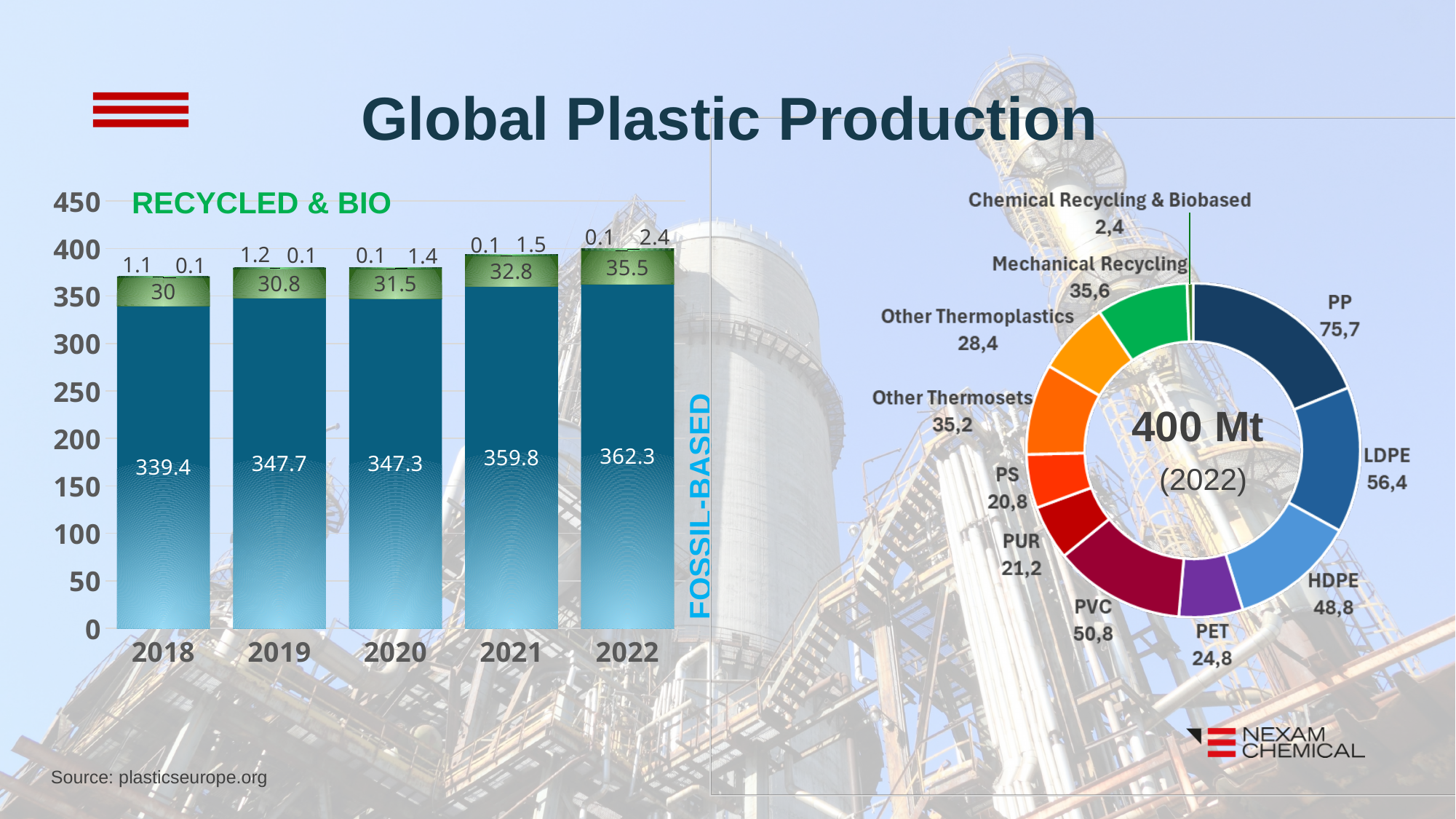
In the donut chart on the right, what is the value for Mechanical Recycling? 35,6 In the donut chart on the right, which segment has the smallest value? Chemical Recycling & Biobased In the donut chart on the right, what is the difference between the values for PP and LDPE? 19,3 In the bar chart on the left, which year has the highest fossil-based value? 2022 In the bar chart on the left, what is the fossil-based value for 2022? 362.3 In the bar chart on the left, which year has the lowest fossil-based value? 2018 In the bar chart on the left, how many years are shown on the x axis? 5 In the bar chart on the left, what is the recycled & bio value labelled on the 2021 bar? 32.8 In the bar chart on the left, what is the difference between the fossil-based values for 2022 and 2018? 22.9 In the donut chart on the right, what is the value for PP? 75,7 In the bar chart on the left, what is the fossil-based value for 2018? 339.4 In the bar chart on the left, does the fossil-based value generally rise or fall from 2018 to 2022? rise